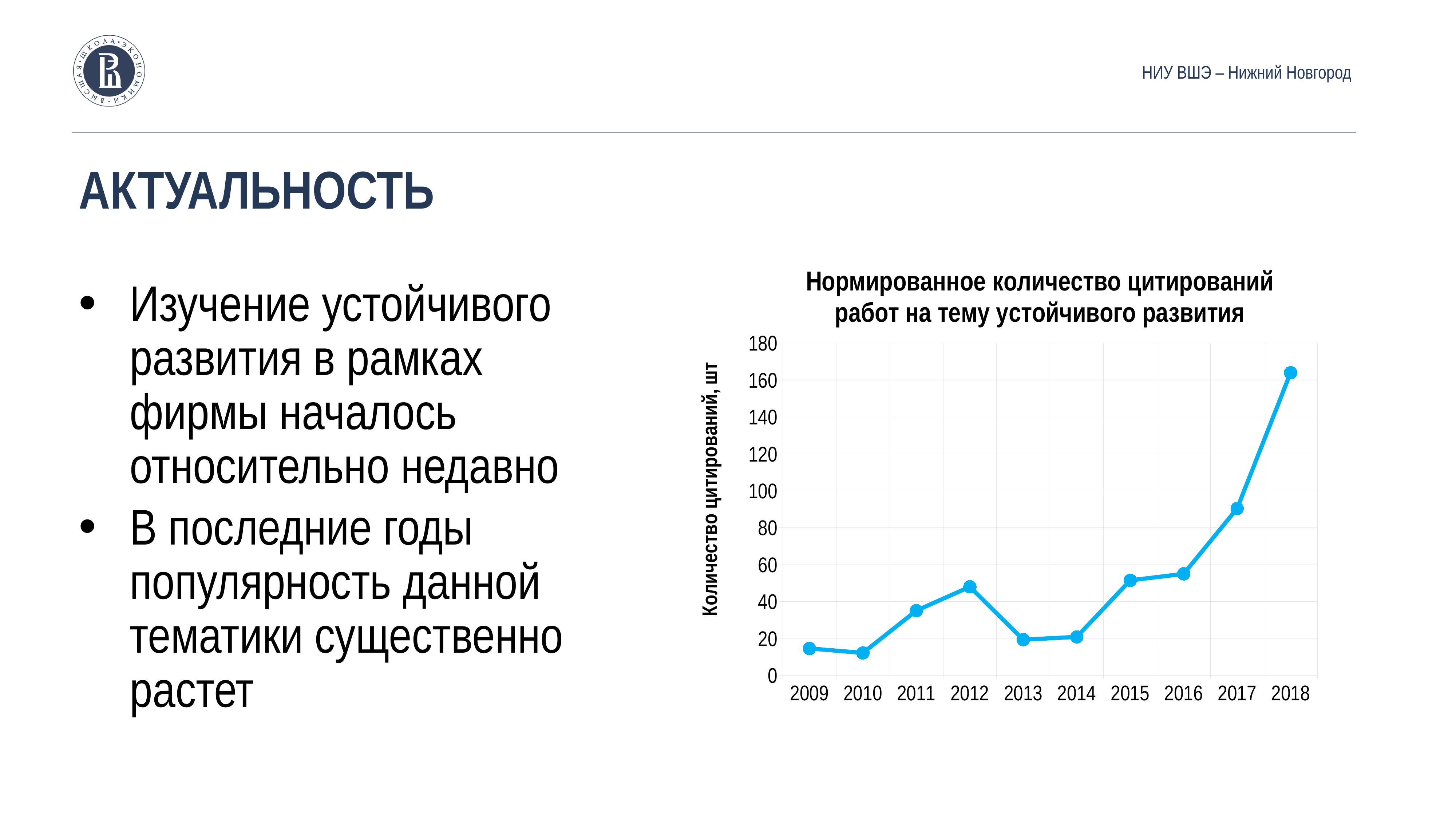
Which year has a higher value, 2016 or 2017? 2017 Which year has a higher value, 2011 or 2012? 2012 Is the value for 2015 greater or less than 40? greater How many years are plotted on the x axis of the chart? 10 What kind of chart is shown on the slide? line chart Do the values rise or fall from 2014 to 2018? rise Which year has the highest normalized number of citations? 2018 Is the value for 2018 greater or less than 140? greater Is the value for 2017 greater or less than 100? less Which year has the lowest normalized number of citations? 2010 What is the label of the vertical axis of the chart? Количество цитирований, шт